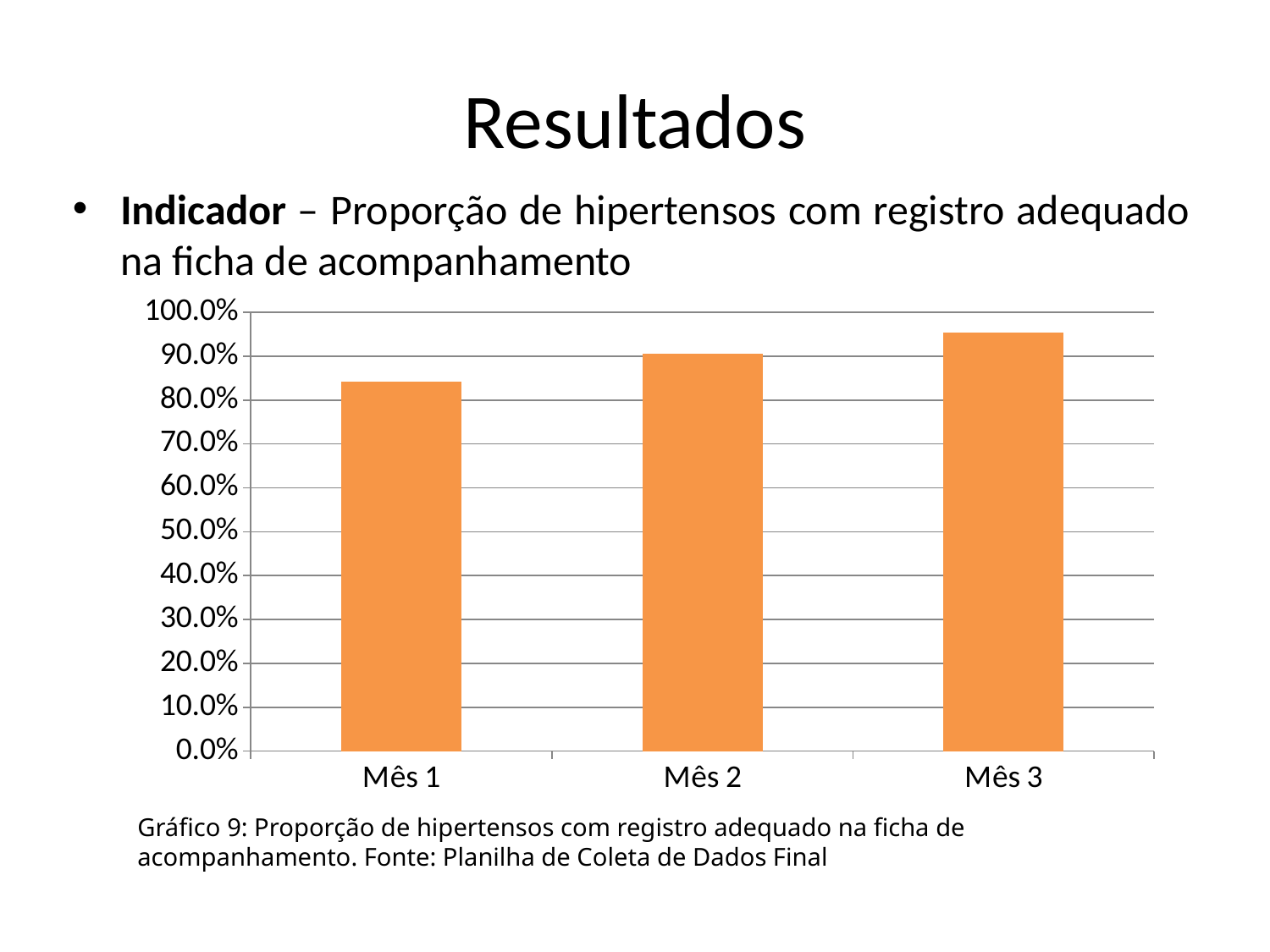
Is the value for Mês 3 greater or less than 90.0%? greater What kind of chart is shown on the slide? Bar chart Which is larger, the value for Mês 1 or the value for Mês 2? Mês 2 Is the value for Mês 1 greater or less than 90.0%? less Is the value for Mês 2 greater or less than 80.0%? greater Do the values rise or fall from Mês 1 to Mês 3? Rise Which month has the lowest proportion of hypertensive patients with adequate records? Mês 1 What colour are the bars in the chart? Orange Which month has the highest proportion of hypertensive patients with adequate records? Mês 3 Which is larger, the value for Mês 1 or the value for Mês 3? Mês 3 How many categories (months) are plotted on the chart? 3